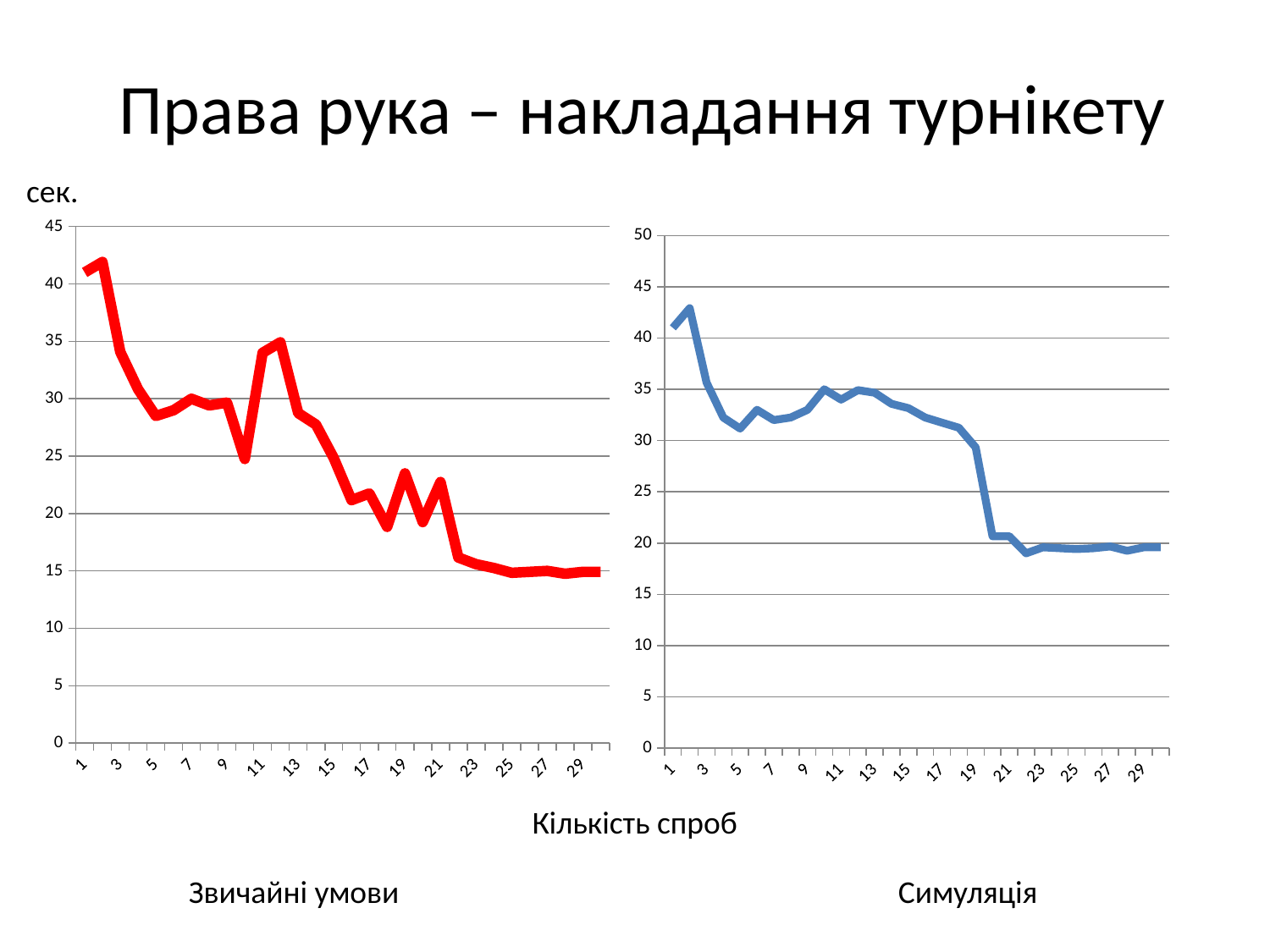
What is the label shown on the x axis below the charts? Кількість спроб What kind of chart is the left chart (Звичайні умови)? line chart What colour is the line in the right chart (Симуляція)? blue In the right chart (Симуляція), is the value for attempt 2 greater or less than 40? greater In the left chart (Звичайні умови), is the value for attempt 19 greater or less than 25? less In the right chart (Симуляція), is the value for attempt 25 greater or less than 25? less What kind of chart is the right chart (Симуляція)? line chart In the right chart (Симуляція), do the values generally rise or fall as the number of attempts increases? fall In the left chart (Звичайні умови), which is larger: the value for attempt 2 or the value for attempt 30? attempt 2 In the right chart (Симуляція), which is larger: the value for attempt 1 or the value for attempt 21? attempt 1 In the left chart (Звичайні умови), do the values generally rise or fall as the number of attempts increases? fall